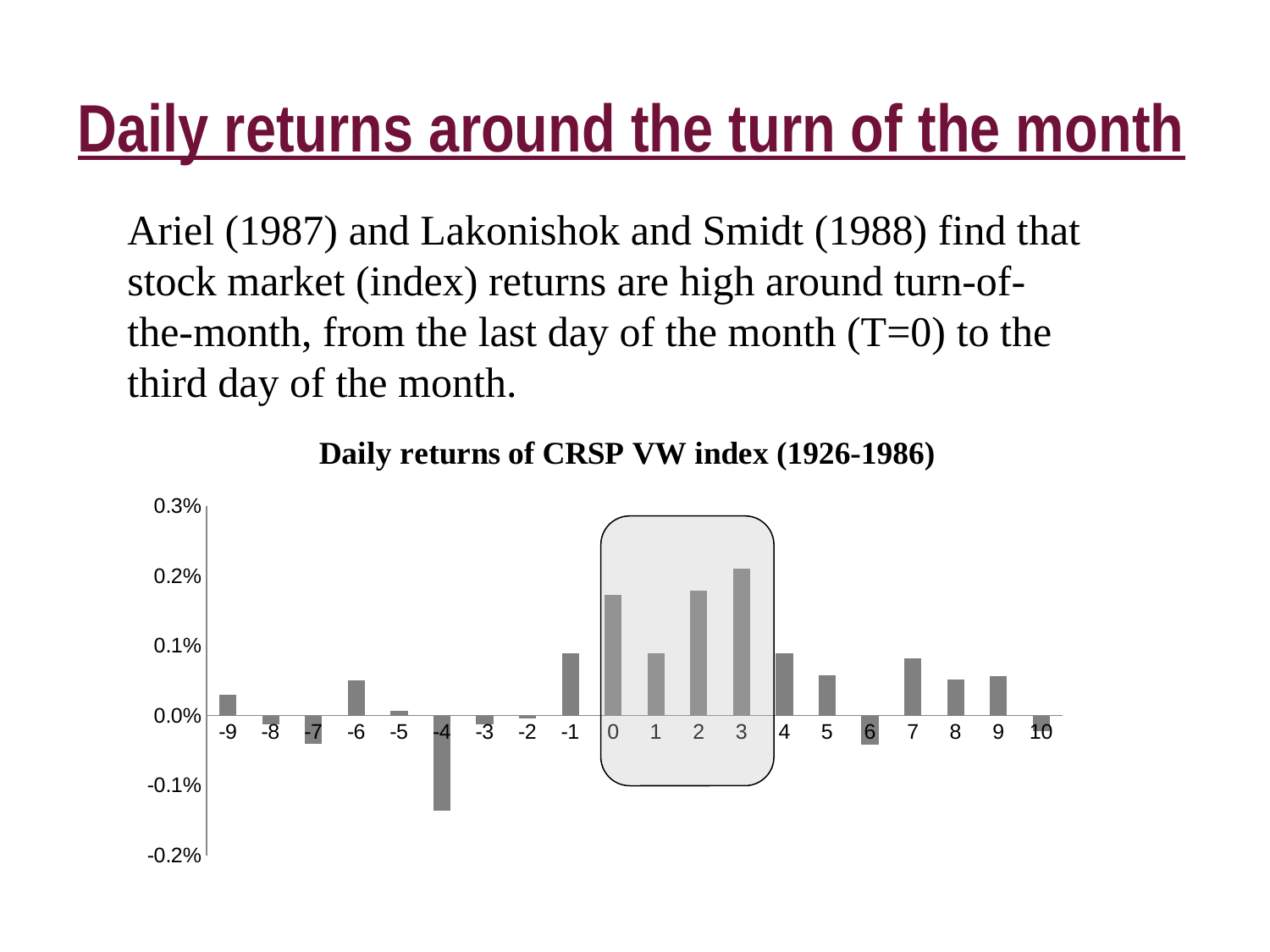
Which day has the lowest daily return in the chart? -4 Which is larger, the value for day -7 or the value for day -4? day -7 What kind of chart is shown on the slide? bar chart What is the title of the chart? Daily returns of CRSP VW index (1926-1986) Is the value for day 0 greater or less than 0.1%? greater Which is larger, the value for day 0 or the value for day 1? day 0 Is the value for day -4 greater or less than -0.1%? less Which day has the highest daily return in the chart? 3 How many days (categories) are plotted on the x axis of the chart? 20 Which days are enclosed by the shaded rounded box on the chart? 0, 1, 2 and 3 Is the value for day 5 greater or less than 0.1%? less